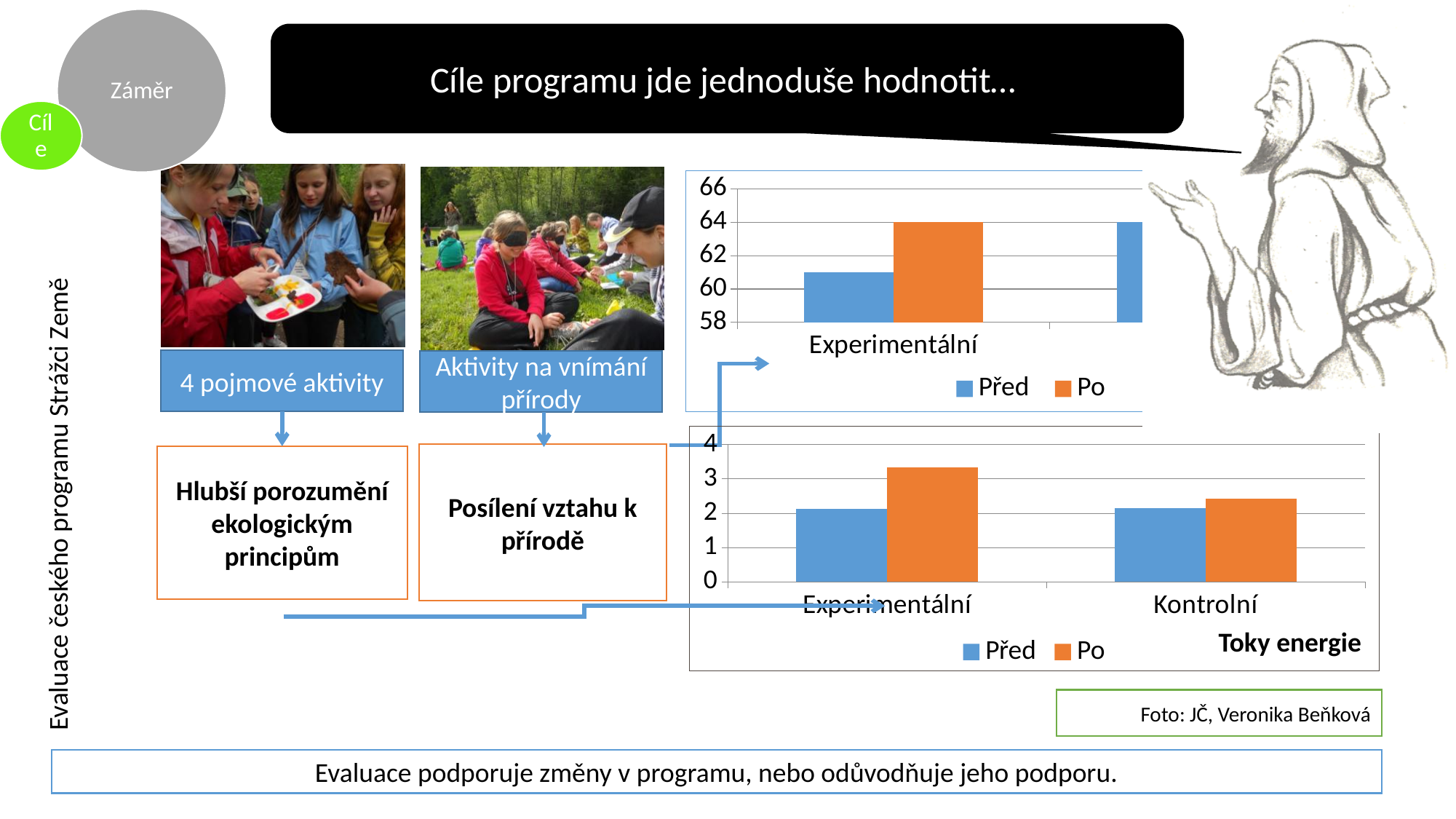
In the bottom chart (Toky energie), which category has the higher Po value? Experimentální In the bottom chart (Toky energie), is the Po value for Experimentální greater or less than 3? greater In the bottom chart (Toky energie), is the Po value for Kontrolní greater or less than 3? less What are the two legend entries in the top chart? Před and Po In the top chart, is the Před value for Experimentální greater or less than 60? greater In the bottom chart (Toky energie), what kind of chart is shown? bar chart In the top chart, which is larger for Experimentální, the Před value or the Po value? Po In the bottom chart (Toky energie), which is larger for Experimentální, the Před value or the Po value? Po In the bottom chart (Toky energie), how many categories are shown on the x axis? 2 In the bottom chart (Toky energie), how many series does the legend list? 2 In the bottom chart (Toky energie), which is larger, the Po value for Experimentální or the Po value for Kontrolní? Experimentální In the top chart, what is the Po value for Experimentální? 64